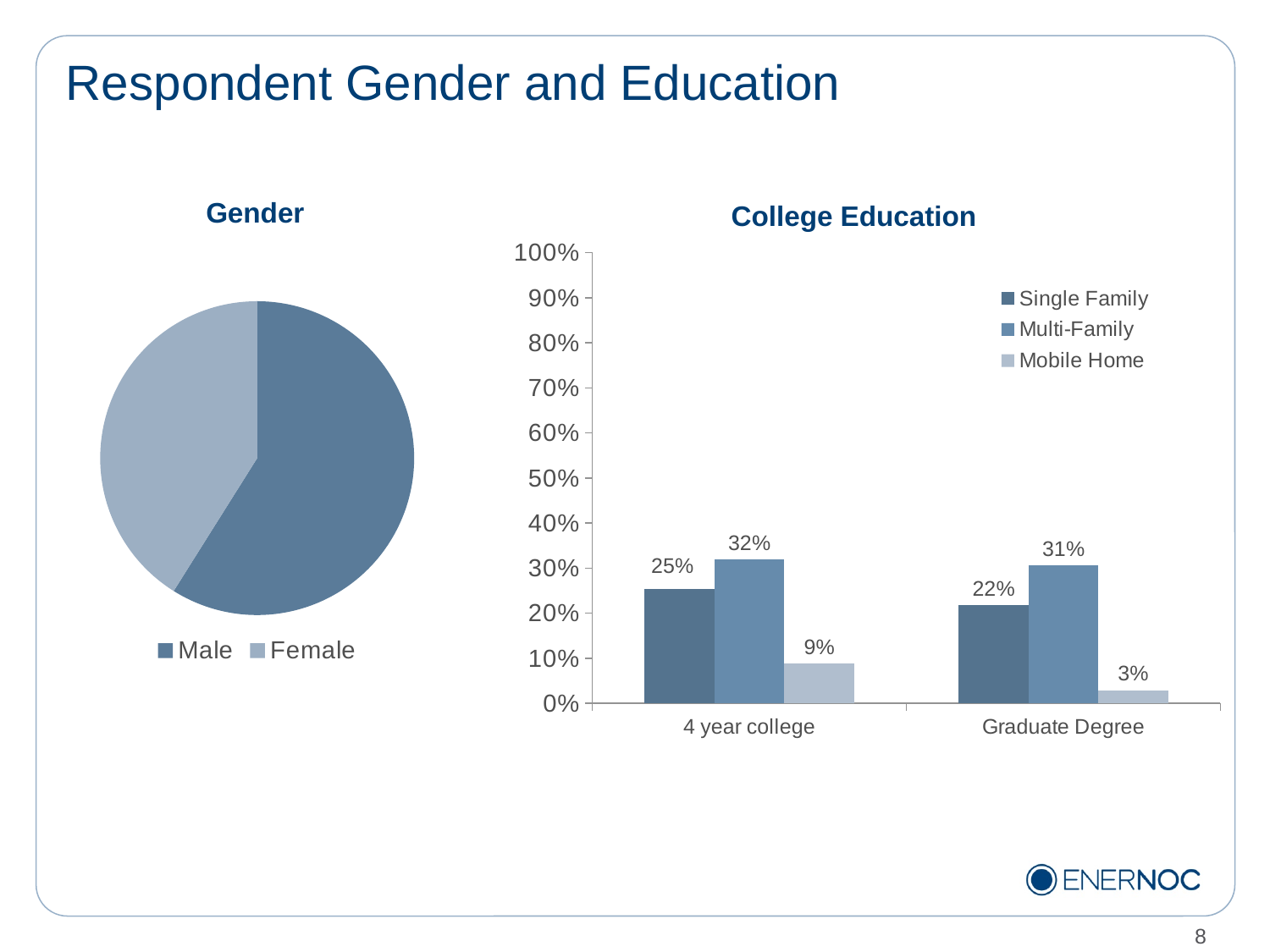
In the College Education chart, how many categories are shown on the x axis? 2 In the College Education chart, which series has the highest value in the 4 year college category? Multi-Family In the College Education chart, what is the value for Multi-Family in the 4 year college category? 32% In the College Education chart, what is the difference between the Mobile Home values for 4 year college and Graduate Degree? 6% In the College Education chart, what is the value for Single Family in the Graduate Degree category? 22% In the College Education chart, which series has the lowest value in the Graduate Degree category? Mobile Home In the College Education chart, which is larger: Single Family for 4 year college or Single Family for Graduate Degree? Single Family for 4 year college What kind of chart is the Gender chart? Pie chart In the College Education chart, how many series does the legend list? 3 In the College Education chart, what is the value for Mobile Home in the Graduate Degree category? 3% In the Gender pie chart, which slice is larger: Male or Female? Male In the College Education chart, what is the difference between the Multi-Family and Single Family values for 4 year college? 7%